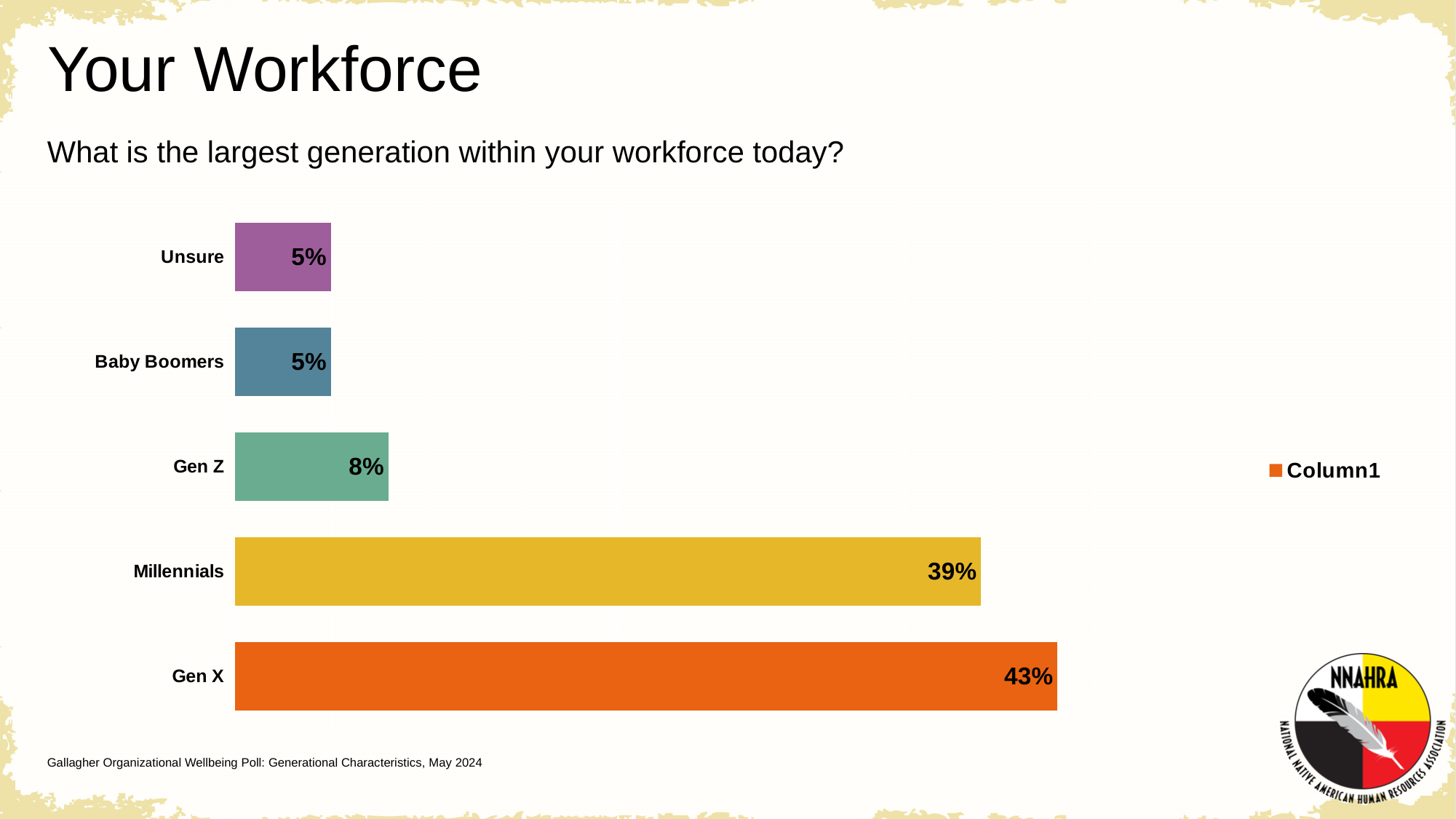
What is the difference between the values for Gen X and Millennials? 4% How many categories are shown in the chart? 5 What kind of chart is shown on the slide? Bar chart What is the legend entry shown next to the chart? Column1 What is the value shown for Gen Z? 8% What colour is the bar for Millennials? Yellow What percentage of respondents said Gen X is the largest generation in their workforce? 43% Which generation has the highest value in the chart? Gen X What is the value shown for Millennials? 39% What is the value shown for Baby Boomers? 5% Which is larger, the value for Gen Z or the value for Unsure? Gen Z What is the difference between the values for Gen Z and Baby Boomers? 3%